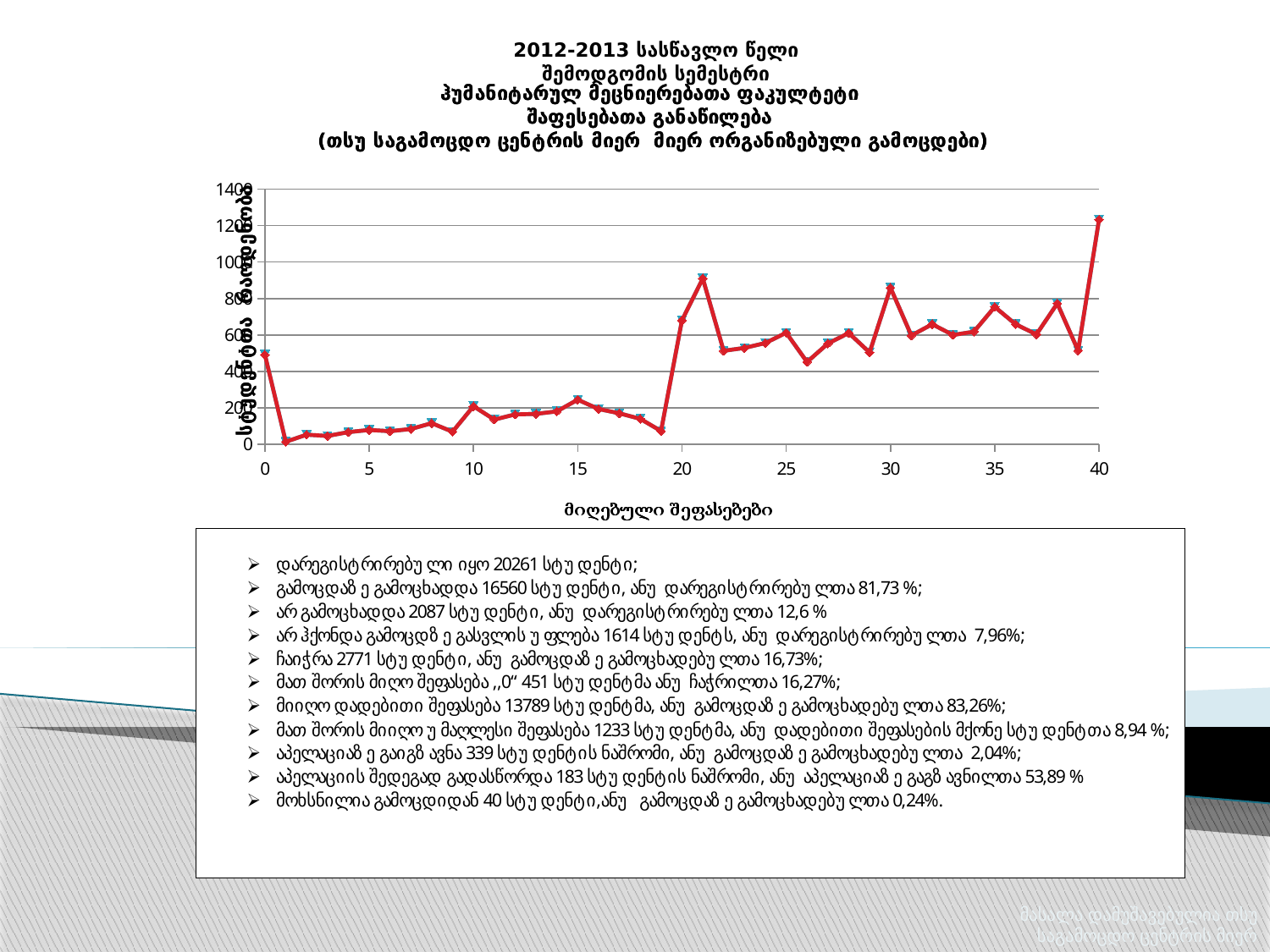
Which has the larger value, x = 21 or x = 10? x = 21 Is the value at x = 19 greater or less than 200? less Between x = 1 and x = 15, do the values generally rise or fall? rise At which x-axis value does the line reach its highest point? 40 What kind of chart is shown on the slide? line chart What is the label on the x axis of the chart? მიღებული შეფასებები Is the value at x = 21 greater or less than 800? greater Is the value at x = 0 greater or less than 600? less At which x-axis value does the line reach its lowest point? 1 Which has the larger value, x = 35 or x = 26? x = 35